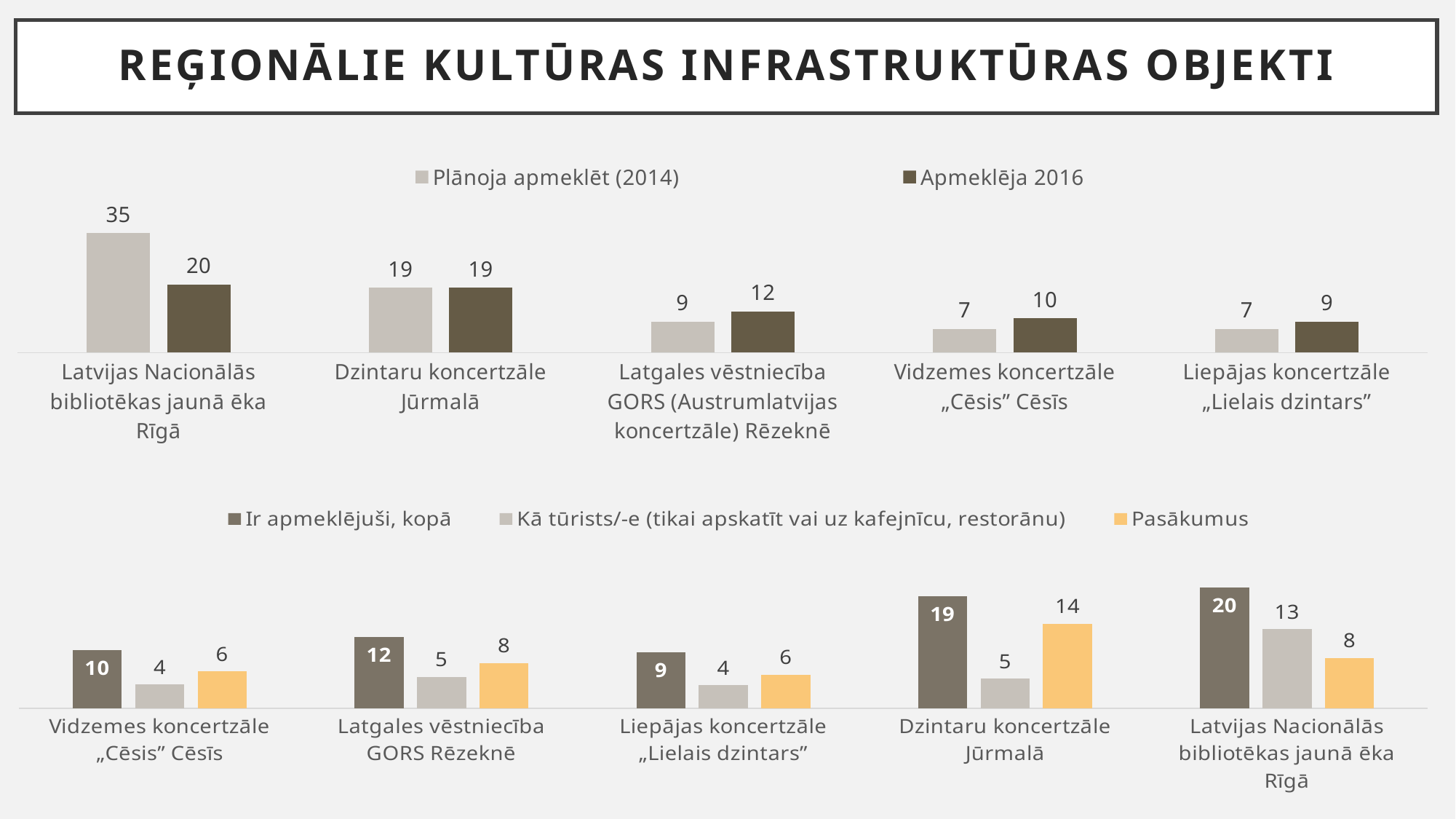
In the bottom chart, what is the "Pasākumus" value for Dzintaru koncertzāle Jūrmalā? 14 In the bottom chart, which is larger for Latgales vēstniecība GORS Rēzeknē: "Kā tūrists/-e" or "Pasākumus"? Pasākumus In the top chart, what is the difference between "Plānoja apmeklēt (2014)" and "Apmeklēja 2016" for Latvijas Nacionālās bibliotēkas jaunā ēka Rīgā? 15 In the bottom chart, which category has the lowest "Ir apmeklējuši, kopā" value? Liepājas koncertzāle „Lielais dzintars” In the bottom chart, how many series does the legend list? 3 In the top chart, how many categories are shown? 5 In the top chart, which category has the highest "Apmeklēja 2016" value? Latvijas Nacionālās bibliotēkas jaunā ēka Rīgā In the top chart, what is the value of "Plānoja apmeklēt (2014)" for Latvijas Nacionālās bibliotēkas jaunā ēka Rīgā? 35 In the bottom chart, what is the "Kā tūrists/-e" value for Latvijas Nacionālās bibliotēkas jaunā ēka Rīgā? 13 What type of chart is the bottom chart? Bar chart In the top chart, how many series does the legend list? 2 In the top chart, what is the value of "Apmeklēja 2016" for Latgales vēstniecība GORS (Austrumlatvijas koncertzāle) Rēzeknē? 12